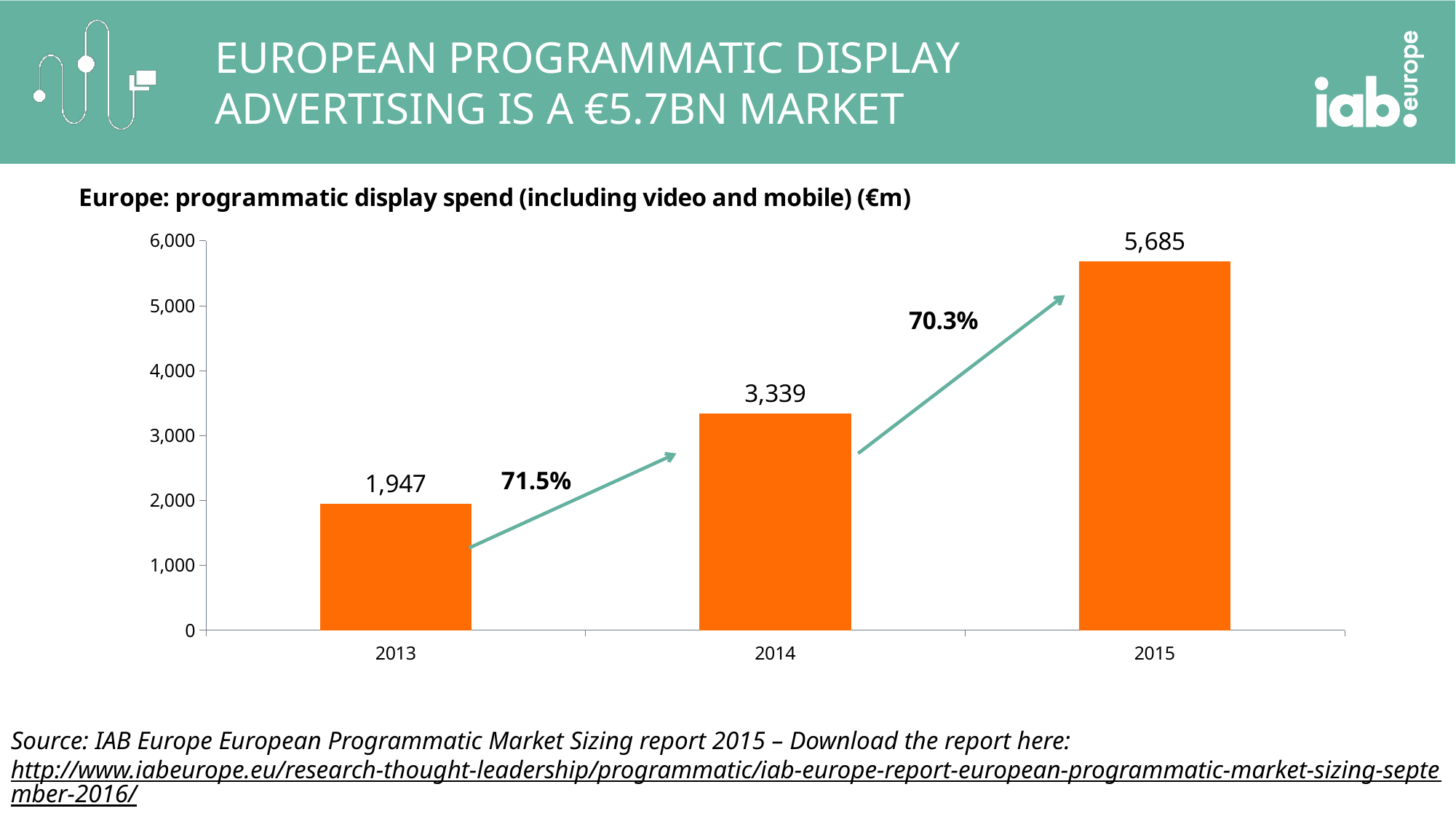
What is the difference in spend between 2014 and 2013? 1,392 What kind of chart is shown on the slide? Bar chart What is the programmatic display spend for 2013? 1,947 Which year has the highest programmatic display spend? 2015 What is the difference in spend between 2015 and 2014? 2,346 What growth percentage is shown between 2014 and 2015? 70.3% Is the value for 2015 greater or less than 5,000? greater What is the programmatic display spend for 2014? 3,339 Which year has the larger spend, 2013 or 2014? 2014 Which year has the lowest programmatic display spend? 2013 What is the programmatic display spend for 2015? 5,685 How many years are shown on the chart? 3